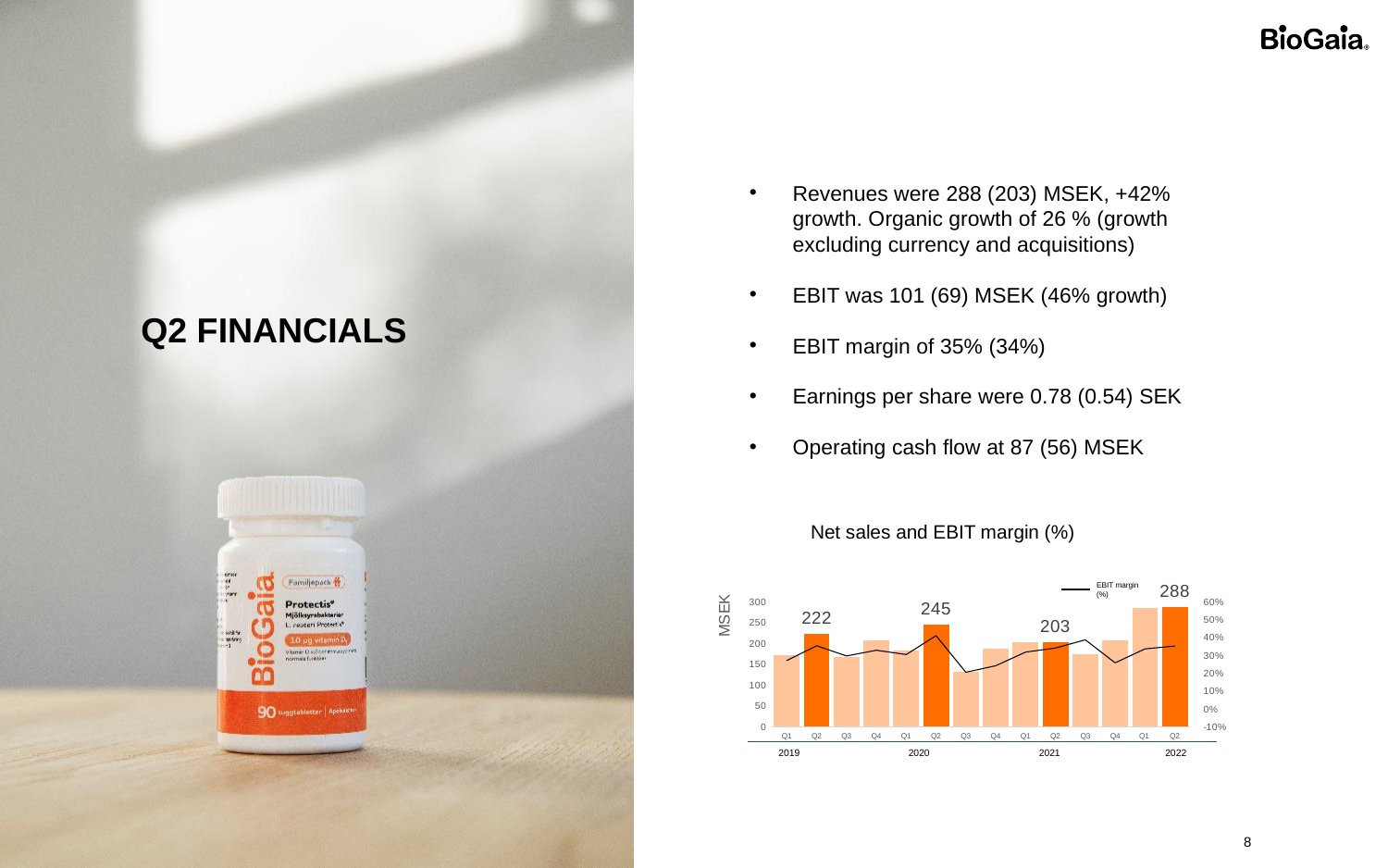
Which quarter had higher net sales, Q2 2020 or Q2 2021? Q2 2020 What is the difference between the labelled net sales for Q2 2020 and Q2 2019? 23 What is the net sales value shown for Q2 2022 in the 'Net sales and EBIT margin (%)' chart? 288 Which quarter has the highest net sales bar in the chart? Q2 2022 Which quarter has the lowest net sales bar in the chart? Q3 2020 How many quarterly bars are plotted in the net sales chart? 14 What net sales value is labelled on the Q2 2019 bar? 222 By how much did net sales in Q2 2022 exceed net sales in Q2 2021, according to the labelled values? 85 What net sales value is labelled on the Q2 2021 bar? 203 What net sales value is labelled on the Q2 2020 bar? 245 Is the net sales bar for Q3 2020 greater or less than 150 MSEK? less What is the title of the chart on the slide? Net sales and EBIT margin (%)